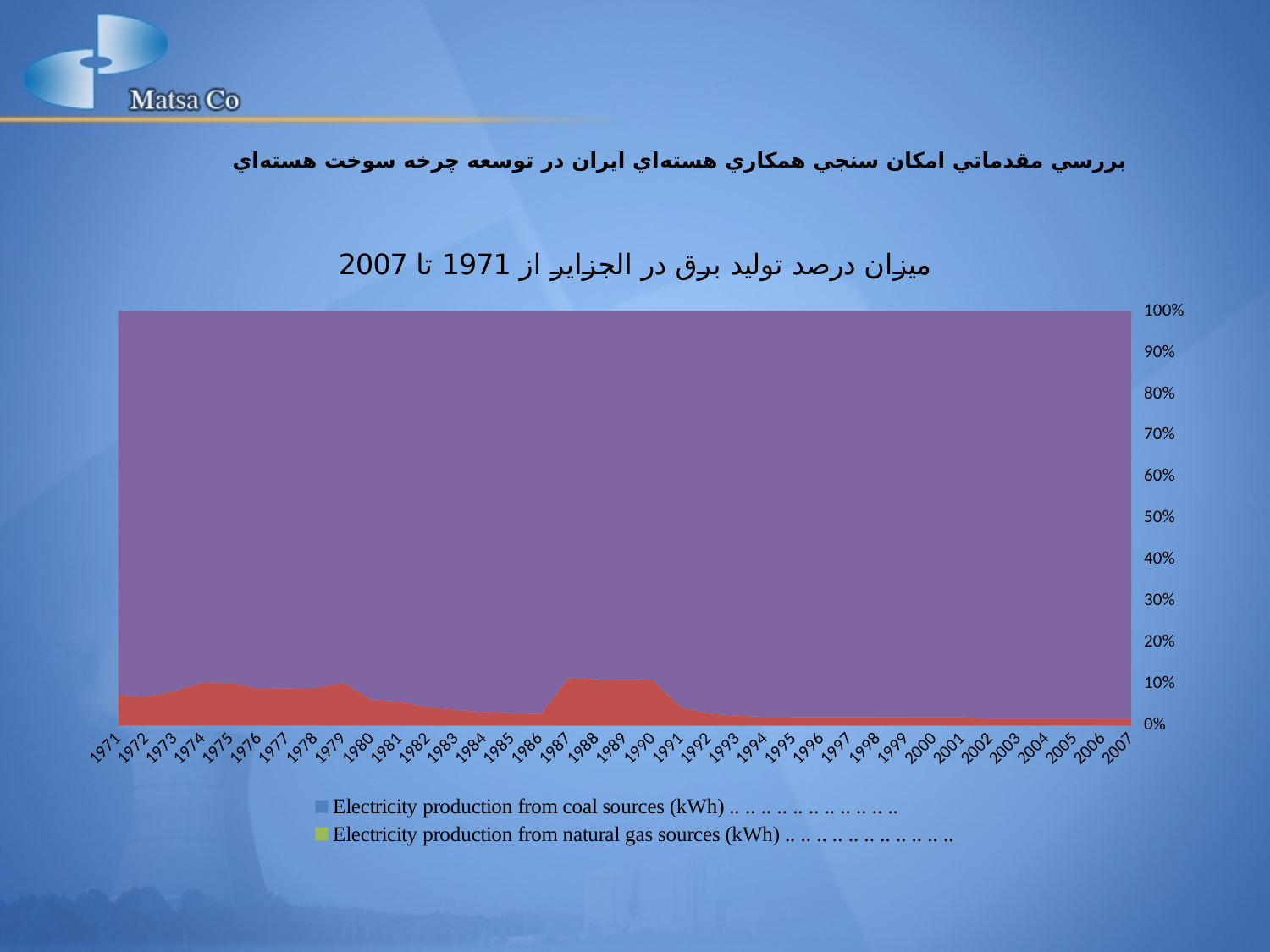
How many series does the legend list? 2 Is the value of the lower (red) area in 2007 greater or less than 10%? less What is the first year shown on the x axis? 1971 What is the last year shown on the x axis? 2007 Is the value of the lower (red) area in 1988 greater or less than 20%? less What kind of chart is shown on the slide? Stacked area chart Is the value of the lower (red) area in 1974 greater or less than 20%? less How many years are shown along the x axis? 37 What is the highest percentage shown on the y axis? 100% Does the lower (red) area rise or fall from 1990 to 2007? fall